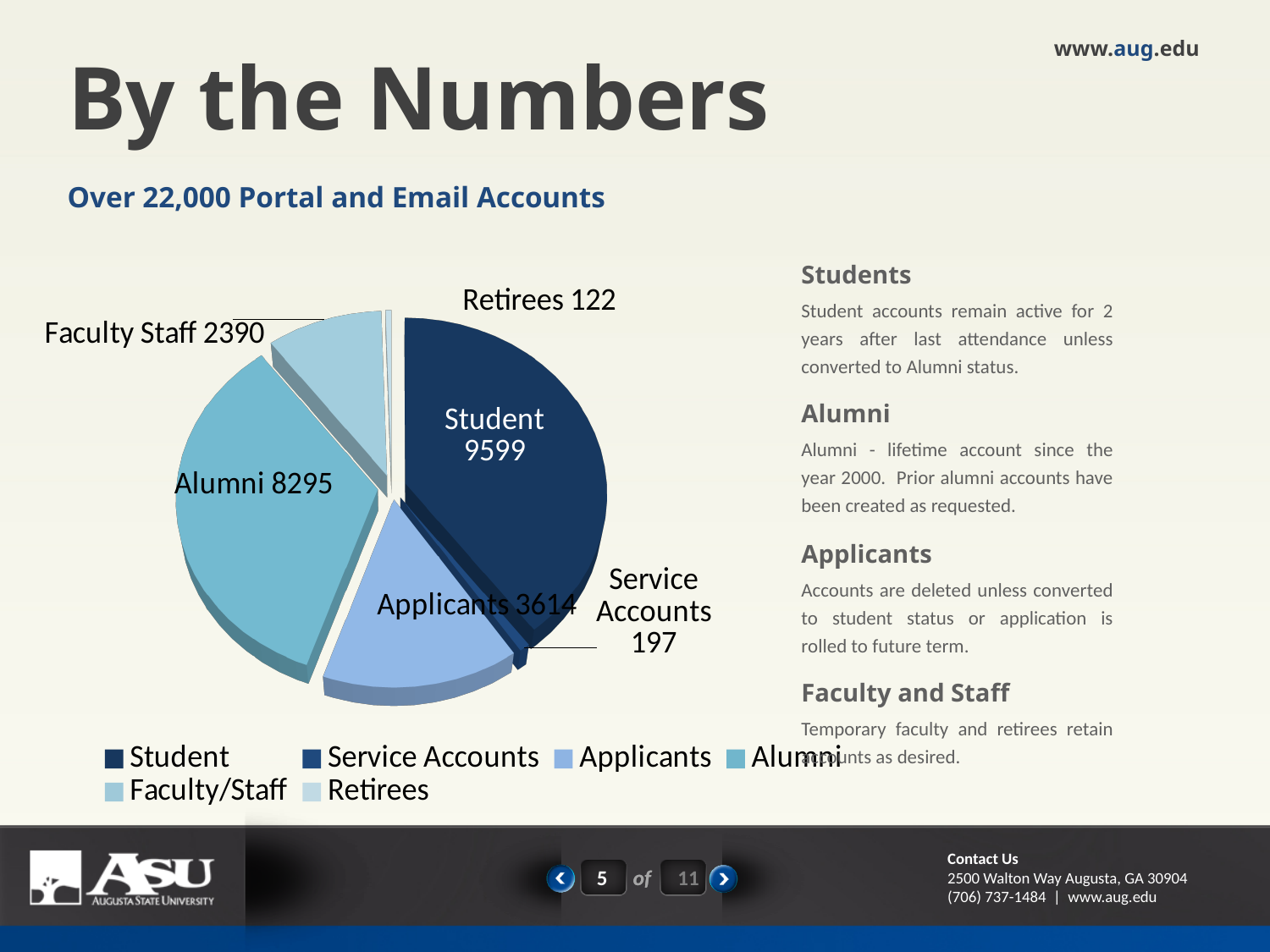
What is the value shown for Retirees? 122 What is the difference between the Applicants value and the Faculty Staff value? 1224 How many categories does the pie chart have? 6 Which category has the largest slice of the pie? Student How many accounts are shown for the Student slice? 9599 What type of chart is shown on the slide? pie chart What is the value shown for Service Accounts? 197 What is the difference between the Student value and the Alumni value? 1304 Which is larger, Applicants or Faculty Staff? Applicants How many entries does the legend list? 6 What is the value shown for Alumni? 8295 Which category has the smallest slice of the pie? Retirees